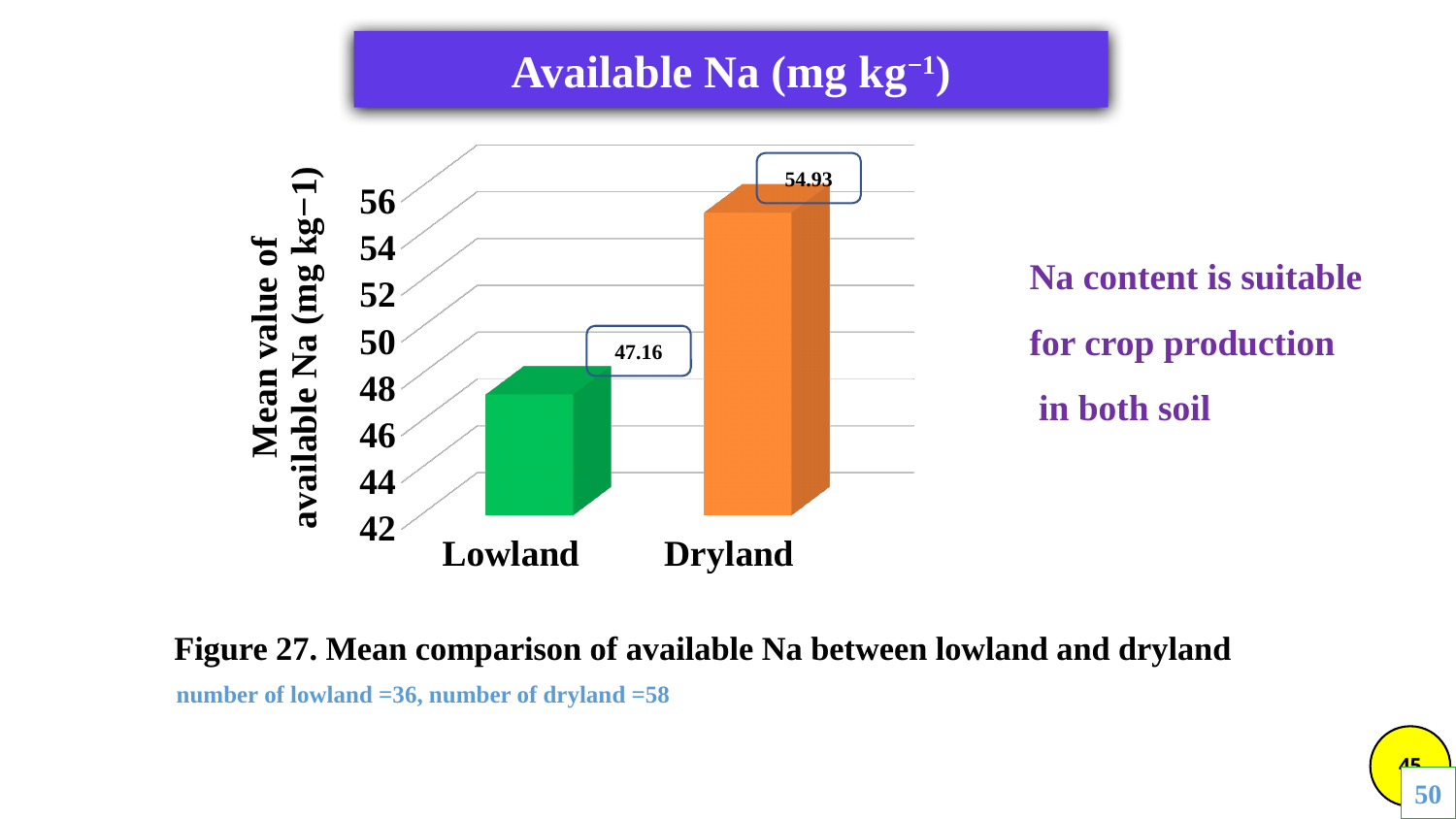
Is the value for Dryland greater or less than 52? greater Which category has the higher mean value of available Na? Dryland What is the mean value of available Na for Dryland? 54.93 Is the mean value of available Na larger for Lowland or Dryland? Dryland What is the mean value of available Na for Lowland? 47.16 Which category has the lower mean value of available Na? Lowland What is the difference between the Dryland and Lowland mean values of available Na? 7.77 What is the title of the chart? Available Na (mg kg⁻¹) How many categories are shown on the x axis of the chart? 2 What colour is the bar for Dryland? orange Is the value for Lowland greater or less than 50? less What kind of chart is shown on the slide? bar chart